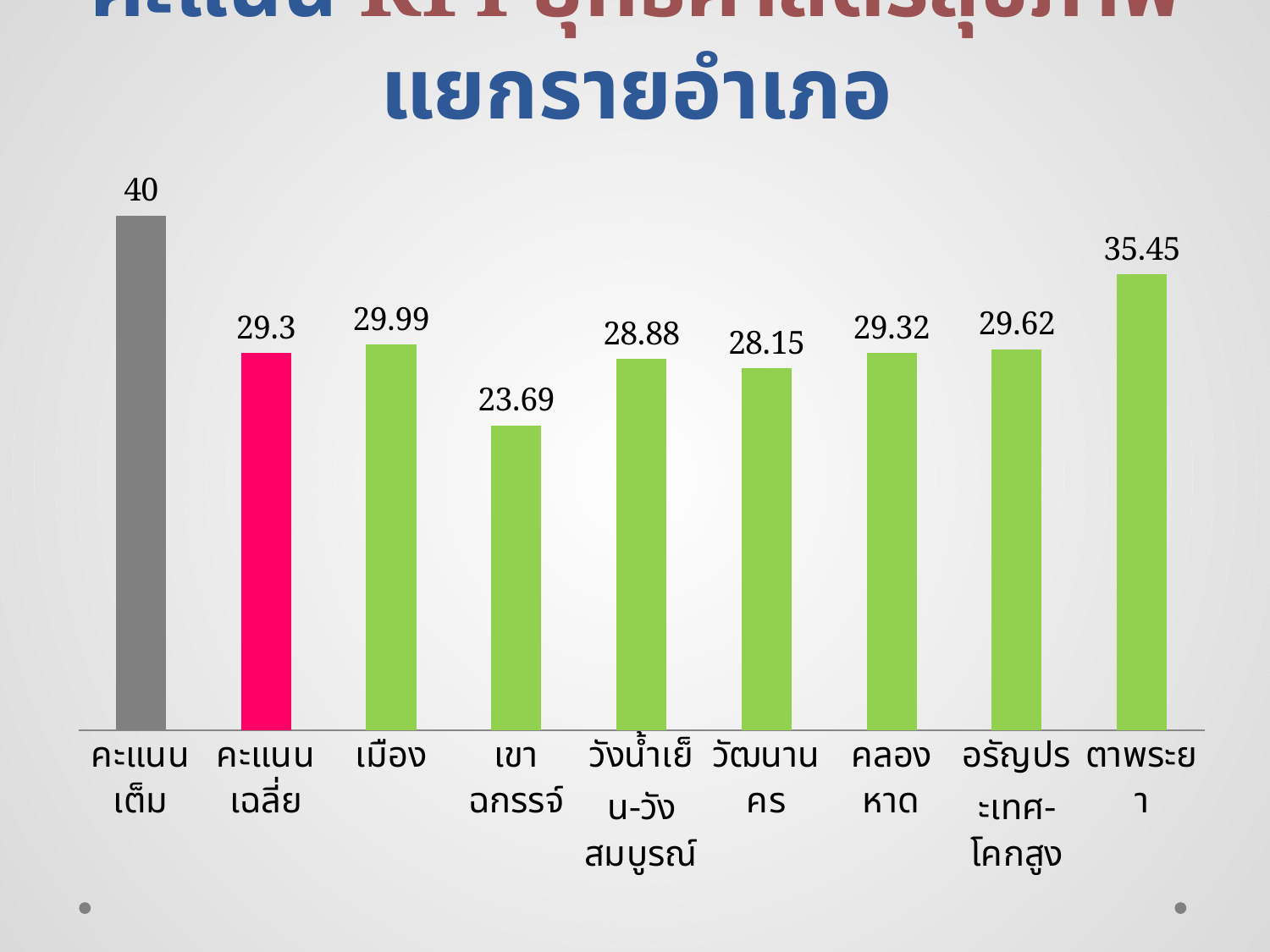
What colour is the bar for คะแนนเฉลี่ย? pink What is the value for ตาพระยา? 35.45 What is the value for วัฒนานคร? 28.15 Which is larger, the value for เมือง or the value for คลองหาด? เมือง How many bars are shown in the chart? 9 What is the difference between the values for ตาพระยา and เขาฉกรรจ์? 11.76 What is the value for คะแนนเต็ม? 40 What is the value for เขาฉกรรจ์? 23.69 Which district (excluding คะแนนเต็ม and คะแนนเฉลี่ย) has the highest value? ตาพระยา Which category has the lowest value? เขาฉกรรจ์ What is the value for คะแนนเฉลี่ย? 29.3 What kind of chart is shown on the slide? bar chart